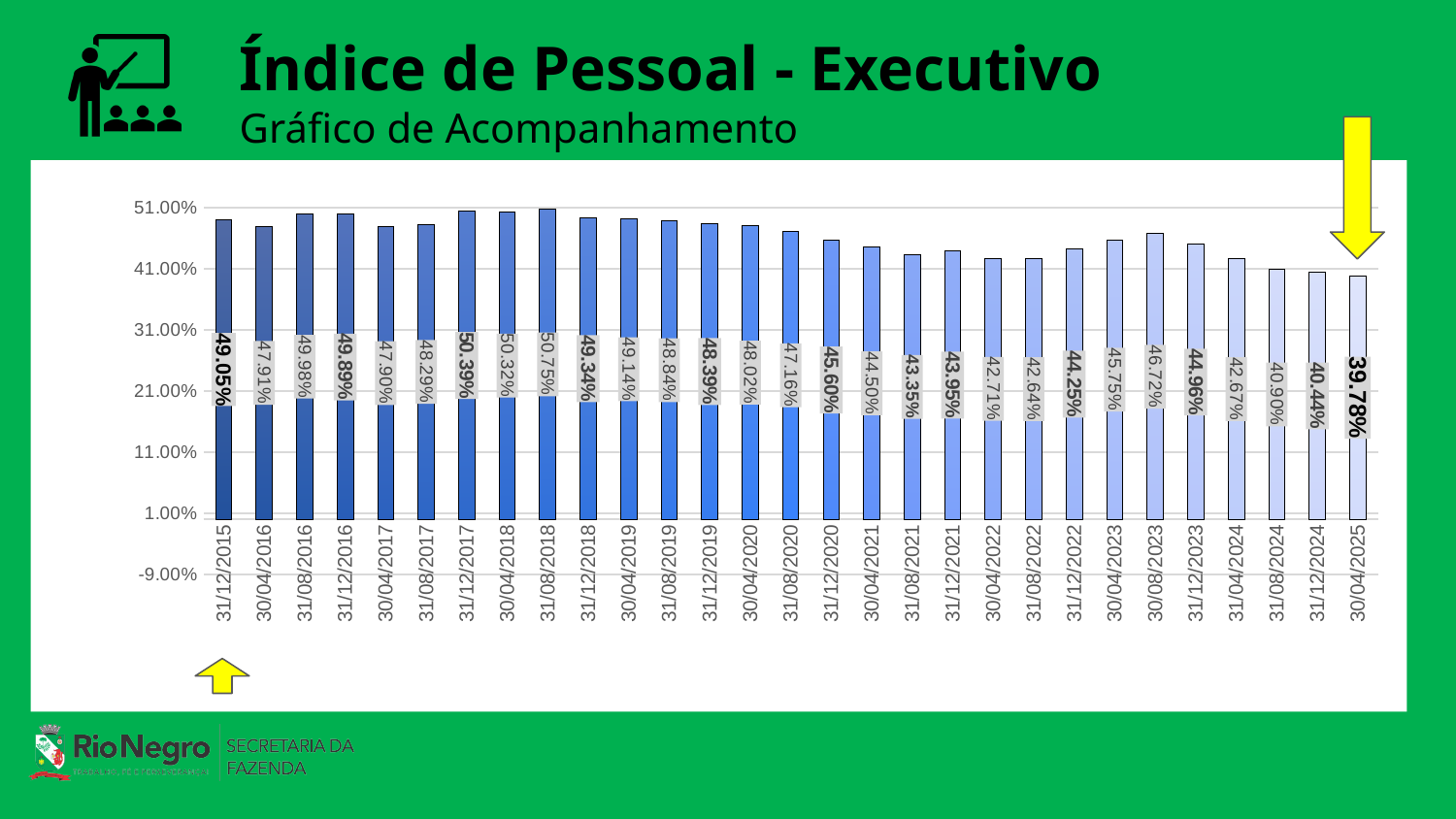
What kind of chart is shown on the slide? Bar chart What is the difference between the values for 31/12/2015 and 30/04/2025? 9.27 percentage points What is the value for 31/12/2020? 45.60% Which is larger, the value for 31/12/2017 or the value for 31/12/2023? 31/12/2017 Overall, do the values rise or fall from 31/12/2015 to 30/04/2025? Fall Which date has the highest value? 31/08/2018 What is the value for 31/12/2015? 49.05% What is the value for 30/04/2025? 39.78% Is the value for 31/08/2018 greater or less than 41.00%? greater Which date has the lowest value? 30/04/2025 How many bars are plotted in the chart? 29